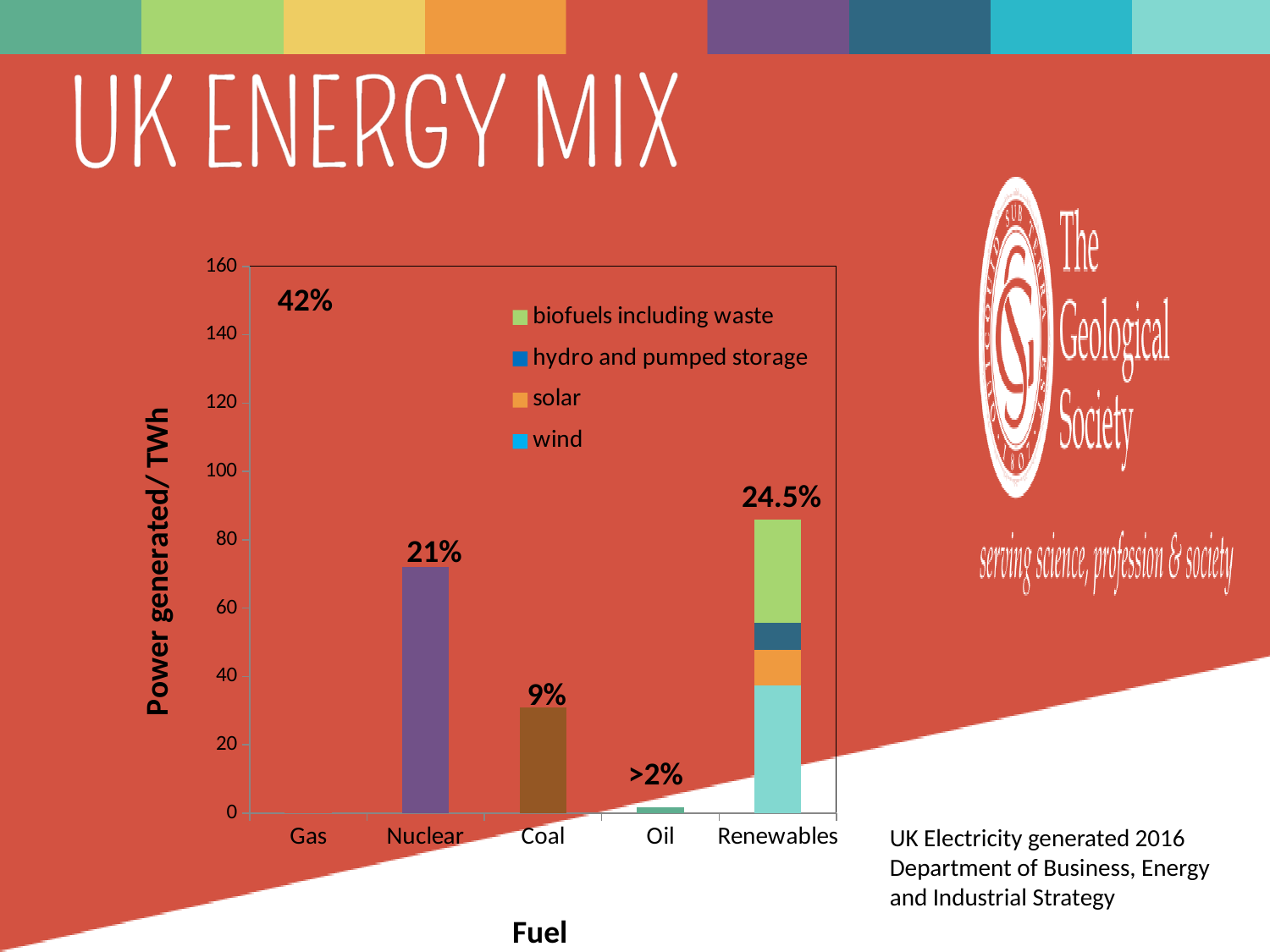
Is the power generated for Coal greater or less than 40 TWh? less Which fuel has the highest percentage label on the chart? Gas What percentage label is shown for Coal? 9% What is the title of the y axis? Power generated/ TWh What percentage label is shown for Oil? >2% Which fuel has the shortest bar on the chart? Oil Which bar is taller, Nuclear or Coal? Nuclear What percentage label is shown for Renewables? 24.5% What percentage label is shown for Nuclear? 21% How many fuel categories are shown on the x axis? 5 How many entries does the legend list? 4 Is the power generated for Nuclear greater or less than 60 TWh? greater